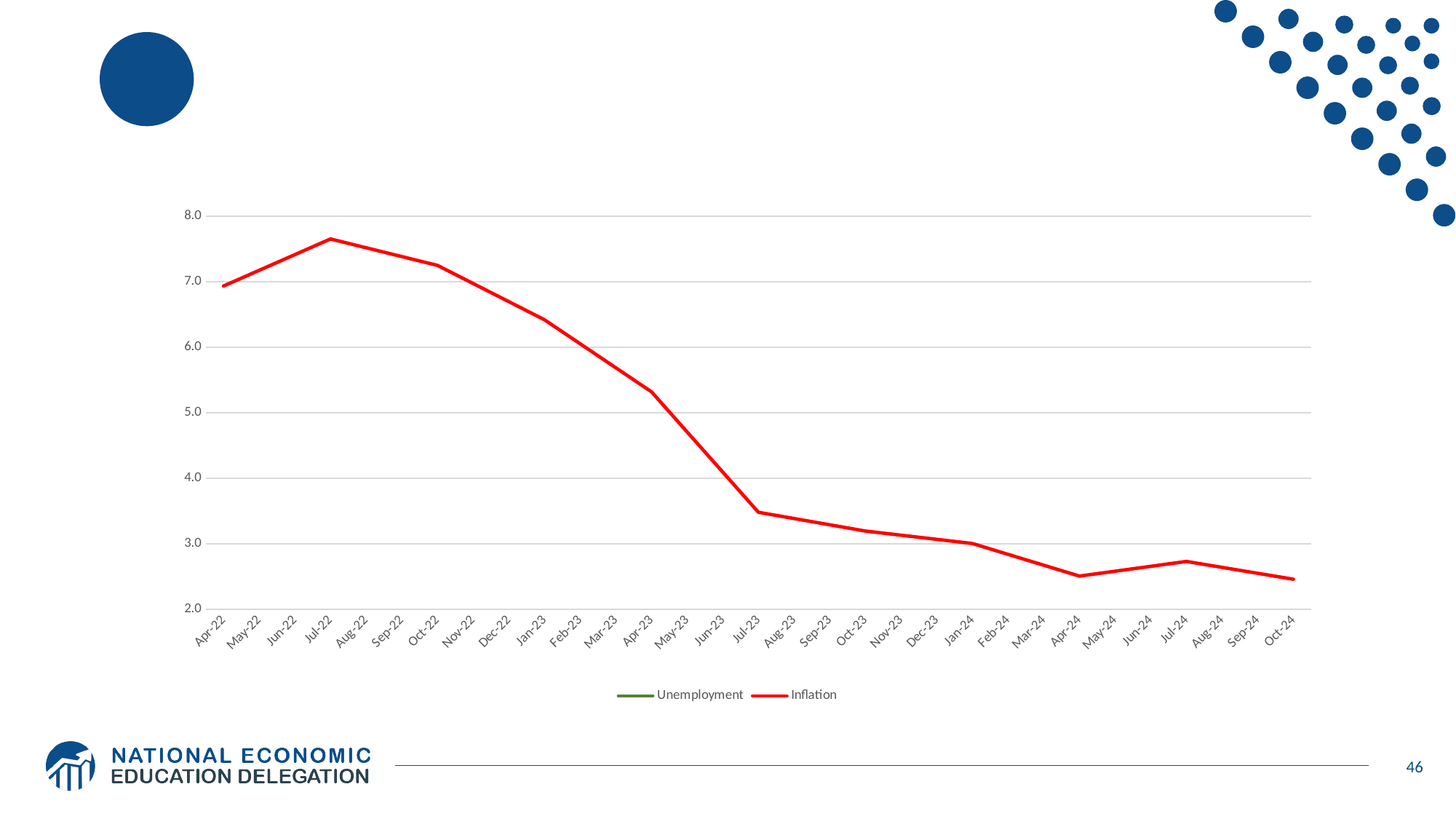
Is the Inflation value for Oct-24 greater or less than 3.0? less What colour is the Inflation line? red How many months are shown along the x axis? 31 What are the two series named in the legend? Unemployment and Inflation Is the Inflation value for Jul-23 greater or less than 4.0? less What kind of chart is shown on the slide? line chart Is the Inflation value for Jul-22 greater or less than 7.0? greater In which month does the Inflation line reach its highest value? Jul-22 What is the first month shown on the x axis? Apr-22 Which has the higher Inflation value, Jan-23 or Jul-23? Jan-23 How many series does the legend list? 2 Does the Inflation line generally rise or fall from Jul-22 to Oct-24? fall